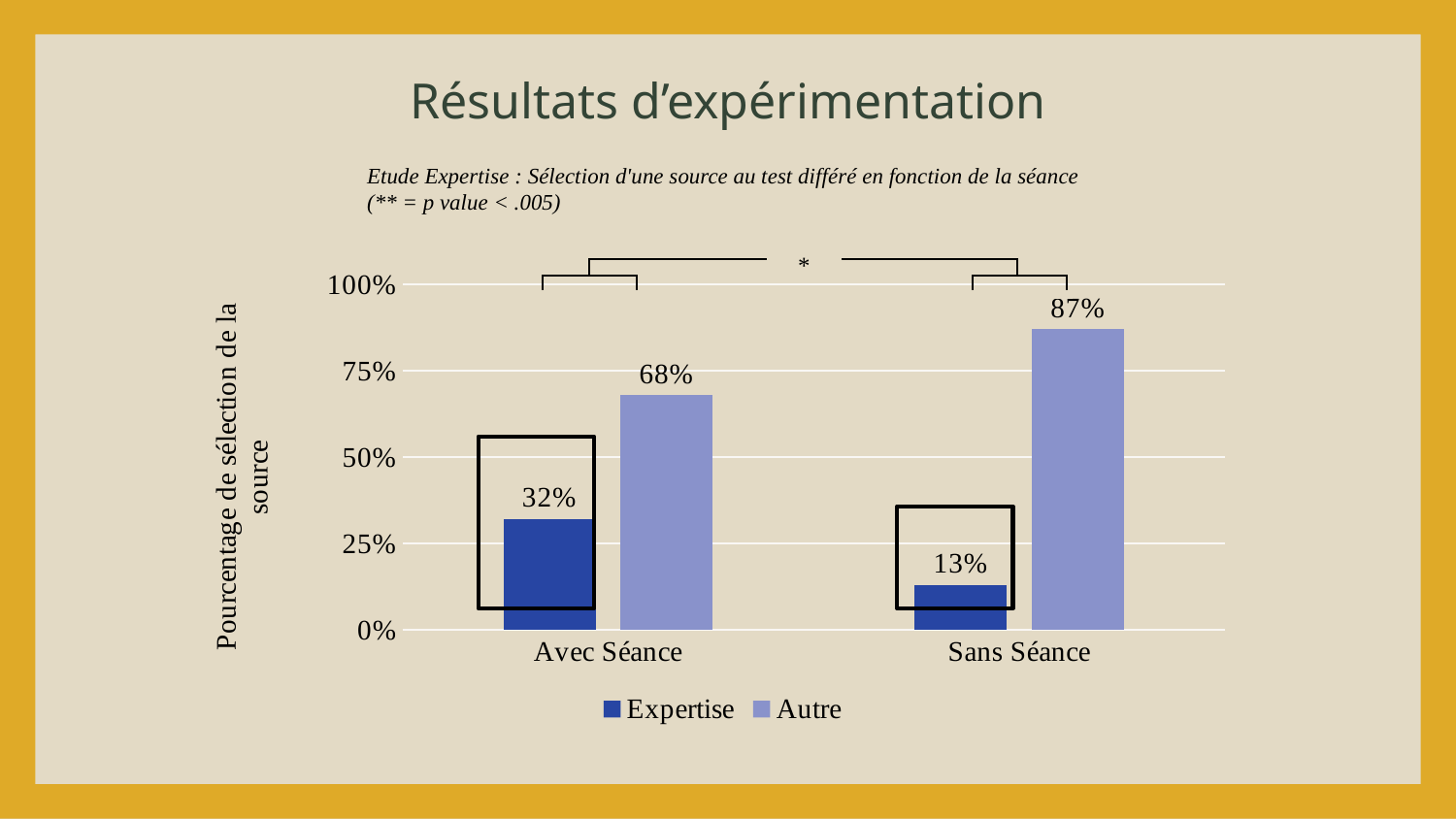
What is the value for Expertise in the Sans Séance category? 13% Which bar has the lowest value on the chart? Expertise, Sans Séance What is the label of the y axis? Pourcentage de sélection de la source How many categories are shown on the x axis? 2 What is the value for Autre in the Sans Séance category? 87% What is the difference between the Autre and Expertise values in the Avec Séance category? 36% What is the value for Expertise in the Avec Séance category? 32% How many series does the legend list? 2 What kind of chart is shown on the slide? Bar chart What is the value for Autre in the Avec Séance category? 68% Which is larger: Expertise in Avec Séance or Expertise in Sans Séance? Expertise in Avec Séance Which bar has the highest value on the chart? Autre, Sans Séance